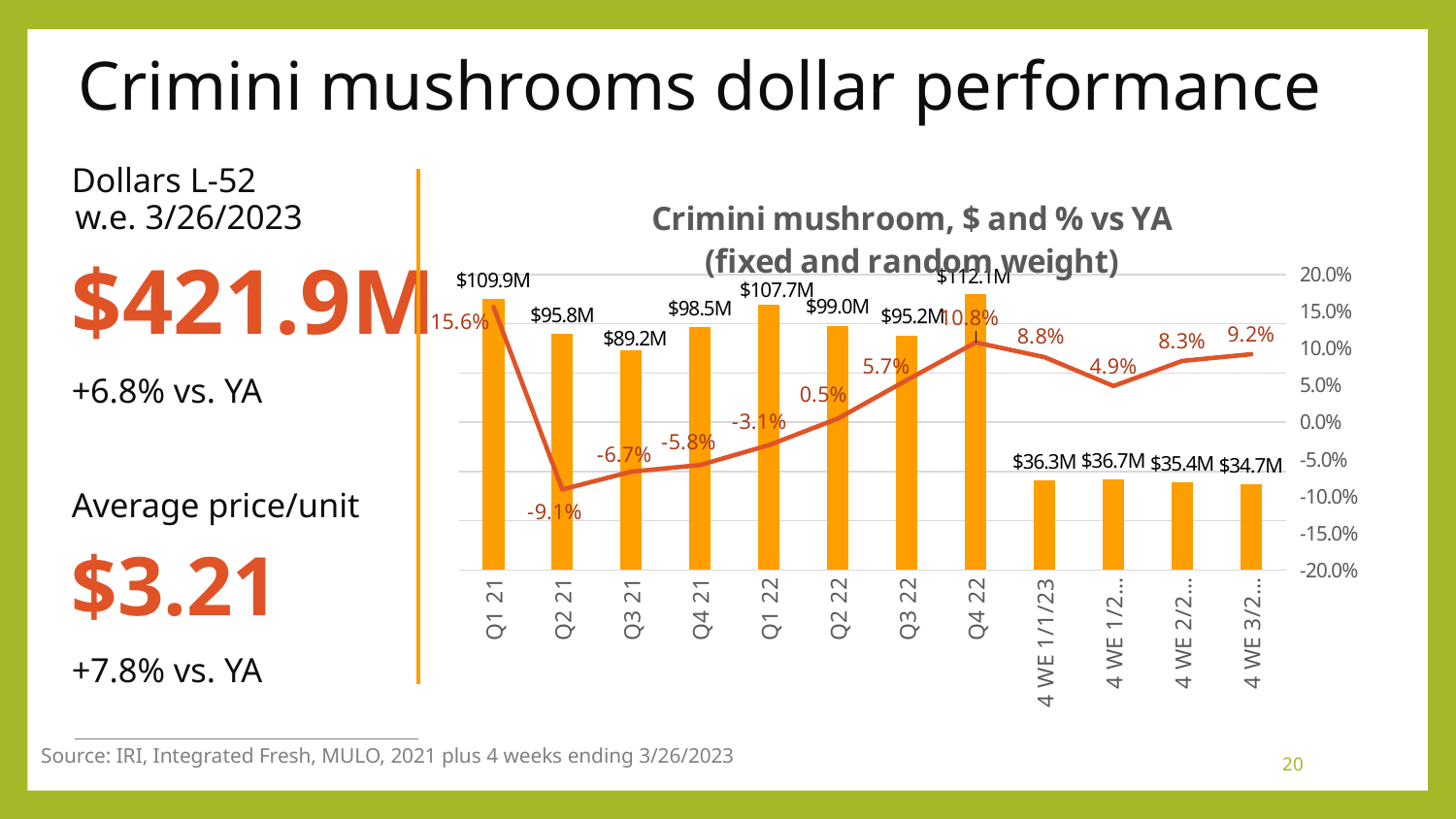
What is the dollar value shown for Q1 21? $109.9M What is the difference in dollar value between Q4 22 and Q1 22? $4.4M Which period has the highest dollar value bar? Q4 22 How many periods are plotted along the x axis? 12 Which has the larger dollar value, Q2 21 or Q4 21? Q4 21 Does the % vs YA line rise or fall from Q2 21 to Q4 22? Rise What is the % vs YA value shown for Q4 22? 10.8% What is the % vs YA value shown for Q2 21? -9.1% Which period has the lowest % vs YA value on the line? Q2 21 What is the dollar value shown for the 4 WE 1/1/23 period? $36.3M Among the quarterly periods (Q1 21 to Q4 22), which has the lowest dollar value? Q3 21 What kind of chart is this? Combined bar and line chart